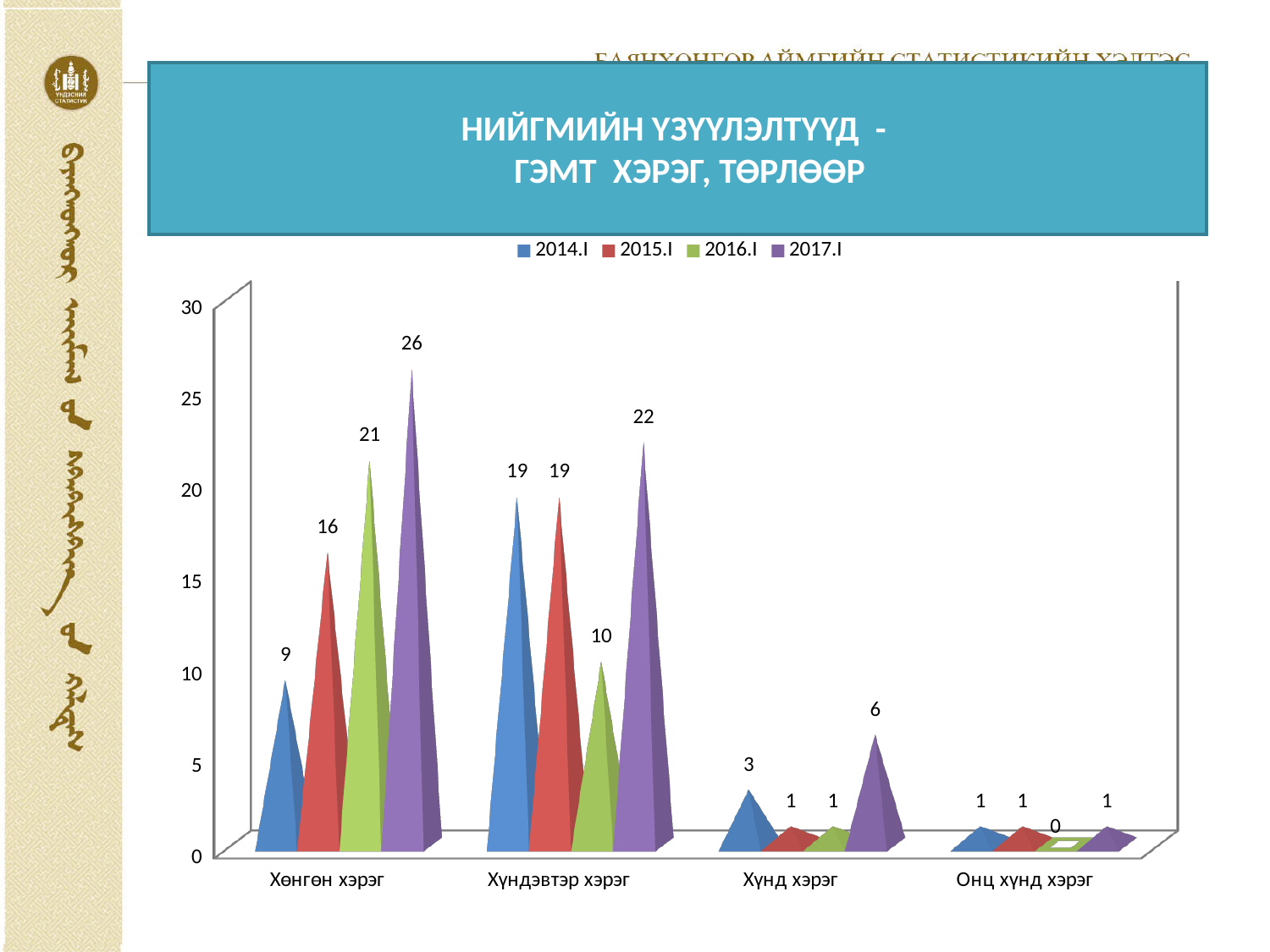
What kind of chart is shown on the slide? bar chart Which series has the lowest value in the Хөнгөн хэрэг category? 2014.I Which series has the highest value in the Хүндэвтэр хэрэг category? 2017.I What is the value for 2016.I in the Онц хүнд хэрэг category? 0 How many series does the legend list? 4 What is the value for 2016.I in the Хүндэвтэр хэрэг category? 10 How many categories are shown on the x axis? 4 What is the difference between the 2017.I and 2014.I values in the Хөнгөн хэрэг category? 17 Which is larger in the Хүнд хэрэг category: the 2014.I value or the 2017.I value? 2017.I What is the value for 2014.I in the Хүнд хэрэг category? 3 How do the values for 2017.I change from Хөнгөн хэрэг to Онц хүнд хэрэг along the x axis? They fall What is the value for 2017.I in the Хөнгөн хэрэг category? 26